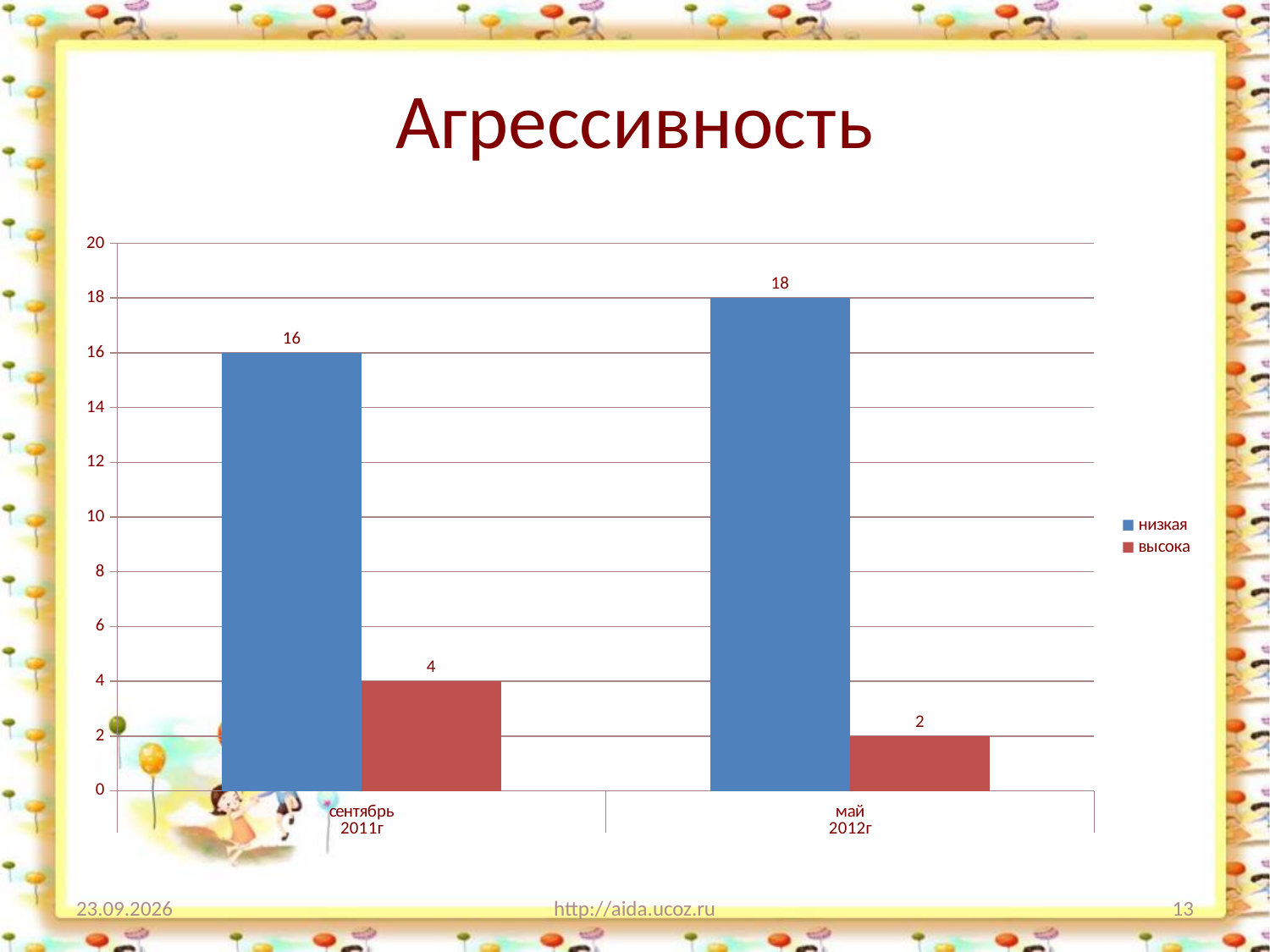
Which category has the highest value for низкая? май 2012г What is the value for высока in сентябрь 2011г? 4 What is the title of the slide? Агрессивность How many series does the legend list? 2 What is the value for низкая in сентябрь 2011г? 16 What is the value for низкая in май 2012г? 18 Which is larger: низкая in сентябрь 2011г or низкая in май 2012г? низкая in май 2012г What kind of chart is shown on the slide? bar chart Which category has the lowest value for высока? май 2012г What is the difference between низкая and высока in сентябрь 2011г? 12 How many categories are shown on the x axis? 2 What is the value for высока in май 2012г? 2